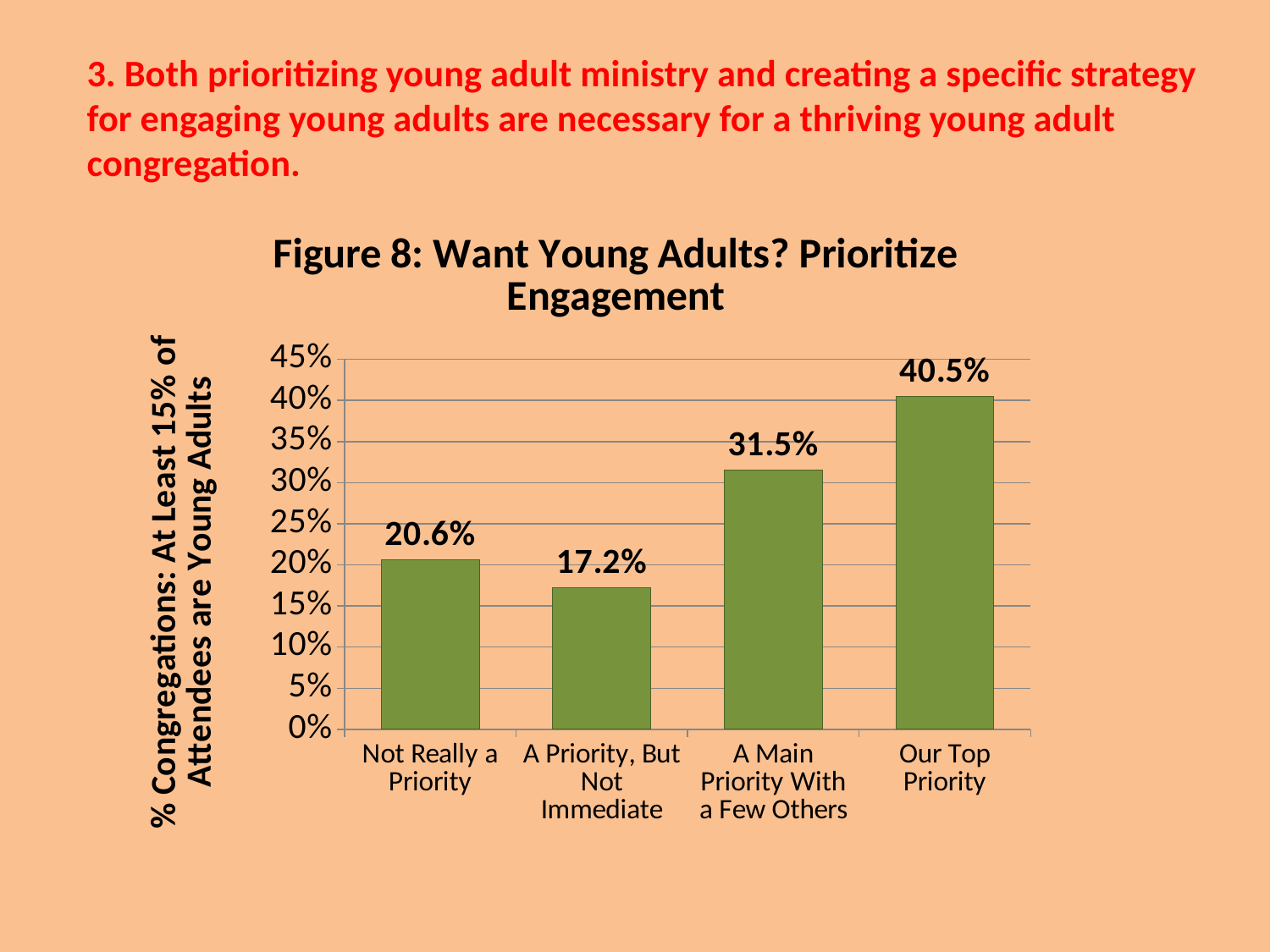
Which category has the highest value? Our Top Priority What is the difference between the values for "Not Really a Priority" and "A Priority, But Not Immediate"? 3.4% What is the value for "A Priority, But Not Immediate"? 17.2% What is the value for "Not Really a Priority"? 20.6% Is the value for "A Main Priority With a Few Others" greater or less than 30%? greater What is the value for "Our Top Priority"? 40.5% Which is larger, the value for "A Main Priority With a Few Others" or the value for "Not Really a Priority"? A Main Priority With a Few Others What is the title of the chart? Figure 8: Want Young Adults? Prioritize Engagement Which category has the lowest value? A Priority, But Not Immediate What is the difference between the values for "Our Top Priority" and "A Main Priority With a Few Others"? 9.0% What kind of chart is shown on the slide? Bar chart How many categories are shown on the x axis? 4